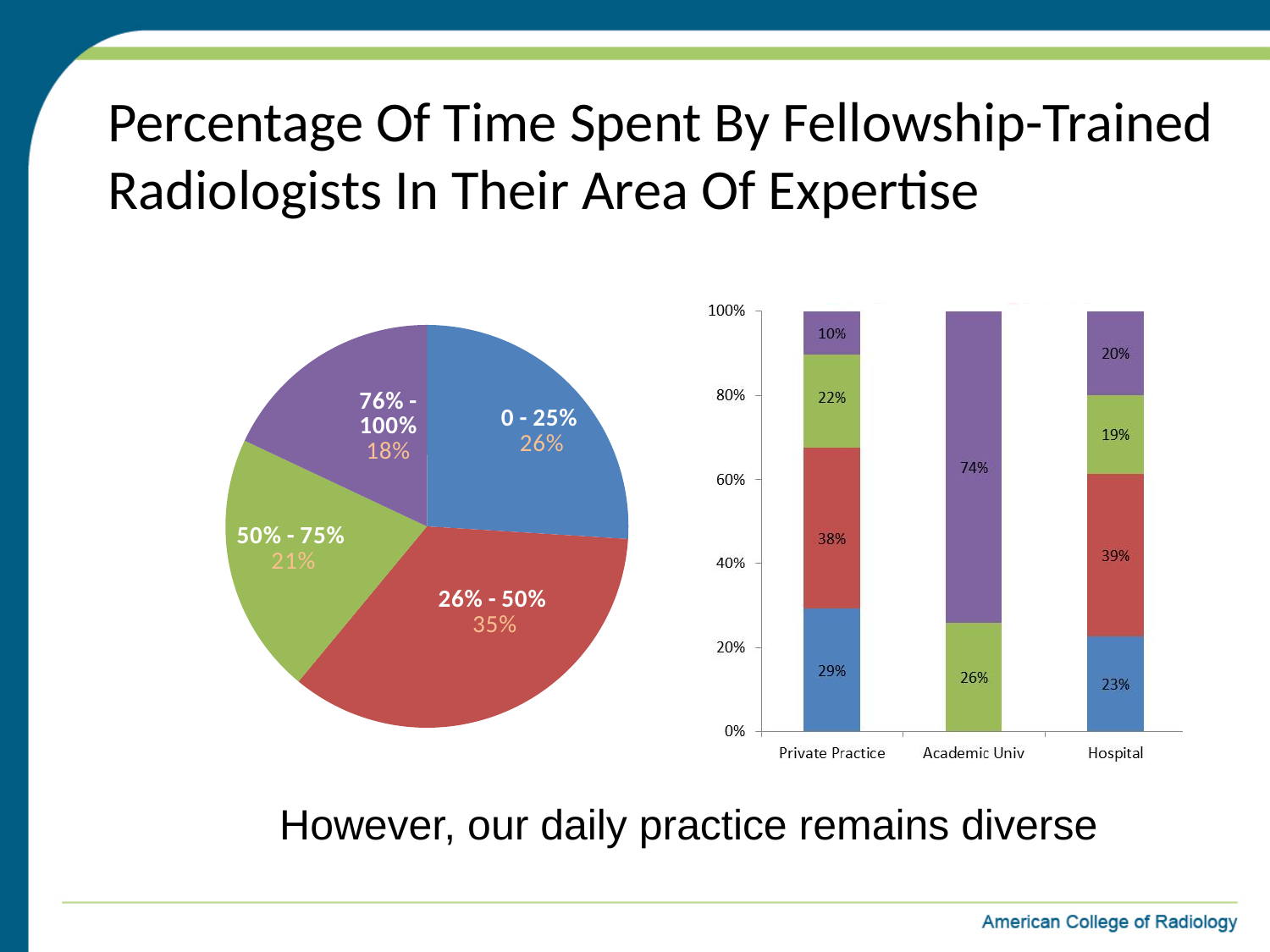
In the pie chart on the left, which slice is the smallest? 76% - 100% In the pie chart on the left, which slice is the largest? 26% - 50% In the pie chart on the left, what share of the pie is the 76% - 100% slice? 18% In the pie chart on the left, what share of the pie is the 26% - 50% slice? 35% What kind of chart is on the right side of the slide? Stacked bar chart In the pie chart on the left, how many slices are there? 4 In the stacked bar chart on the right, how many categories are shown on the x axis? 3 In the stacked bar chart on the right, what is the value of the top (purple) segment of the Hospital bar? 20% In the pie chart on the left, what is the difference between the 0 - 25% slice and the 50% - 75% slice? 5% In the stacked bar chart on the right, what is the value of the largest segment in the Academic Univ bar? 74% In the stacked bar chart on the right, which is larger: the red segment of the Hospital bar or the red segment of the Private Practice bar? Hospital In the stacked bar chart on the right, what is the value of the bottom (blue) segment of the Private Practice bar? 29%